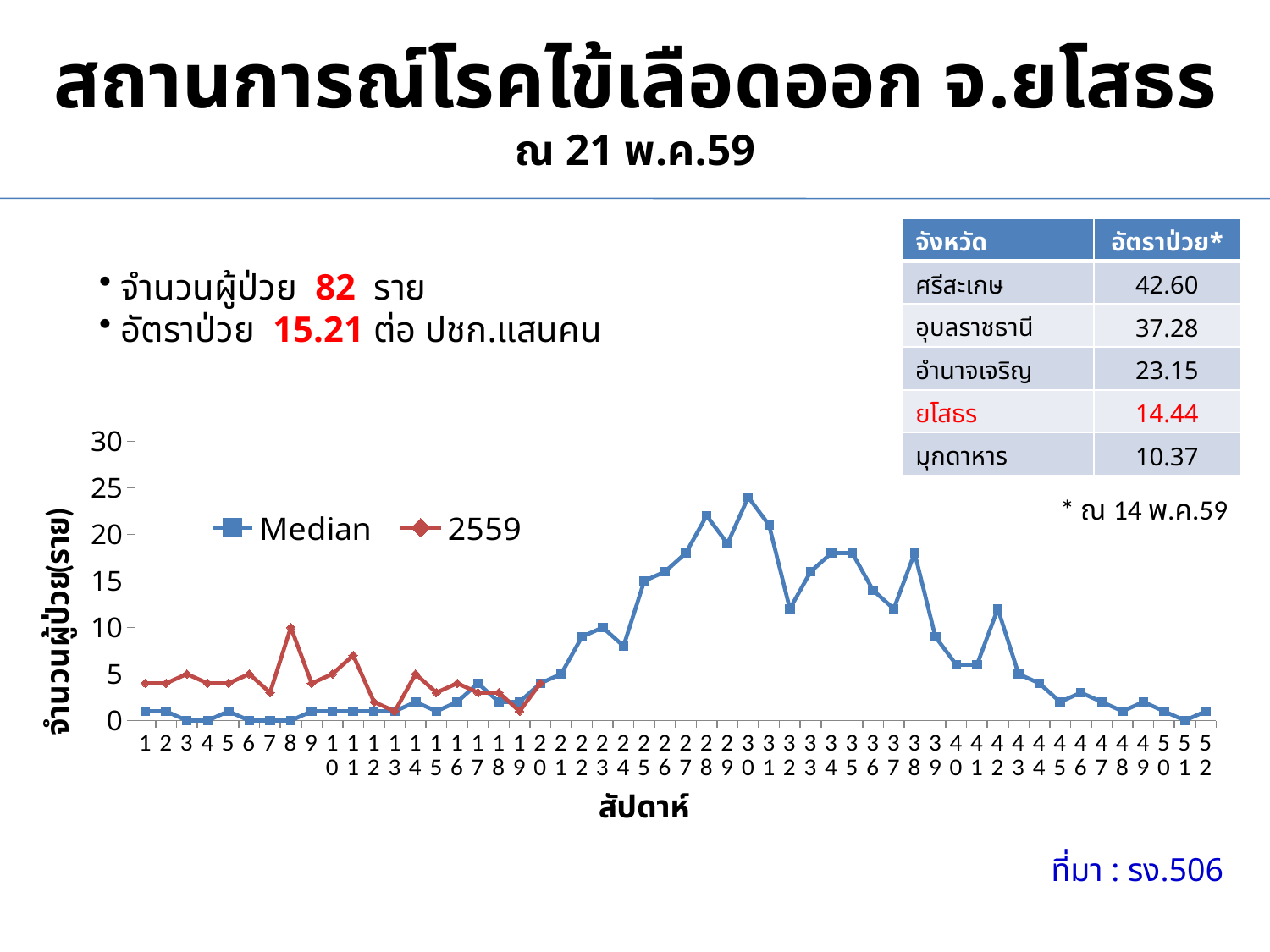
At which week does the 2559 series reach its highest value? 8 At which week does the Median series reach its highest value? 30 How many weeks are shown along the x axis of the chart? 52 Is the Median value at week 5 greater or less than 5? less Does the Median series generally rise or fall from week 30 to week 52? fall How many series does the chart legend list? 2 Is the 2559 value at week 8 greater or less than 5? greater What are the two series named in the chart legend? Median and 2559 At week 8, which series has the higher value, Median or 2559? 2559 Is the Median value at week 30 greater or less than 20? greater What is the title of the x axis of the chart? สัปดาห์ What kind of chart is shown on the slide? line chart